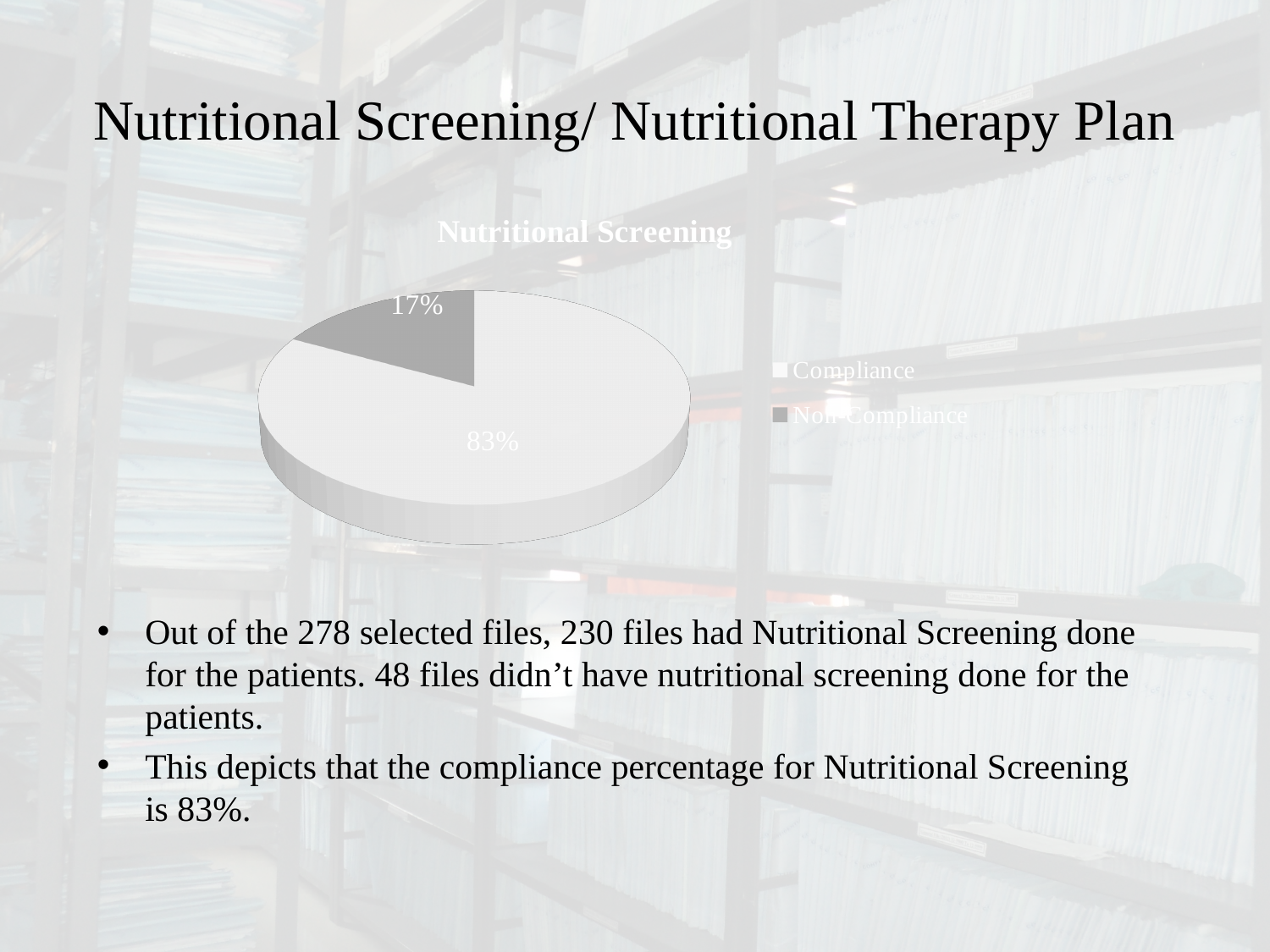
What percentage of the pie is Compliance? 83% Which is larger, the Compliance slice or the Non-Compliance slice? Compliance Which slice of the pie is the smallest? Non-Compliance What is the title of the chart? Nutritional Screening What share of the pie does the Non-Compliance slice take? 17% What kind of chart is shown on the slide? pie chart What is the difference in percentage points between the Compliance and Non-Compliance slices? 66 What percentage of the pie is Non-Compliance? 17% Which slice of the pie is the largest? Compliance How many slices does the pie chart have? 2 How many entries does the legend list? 2